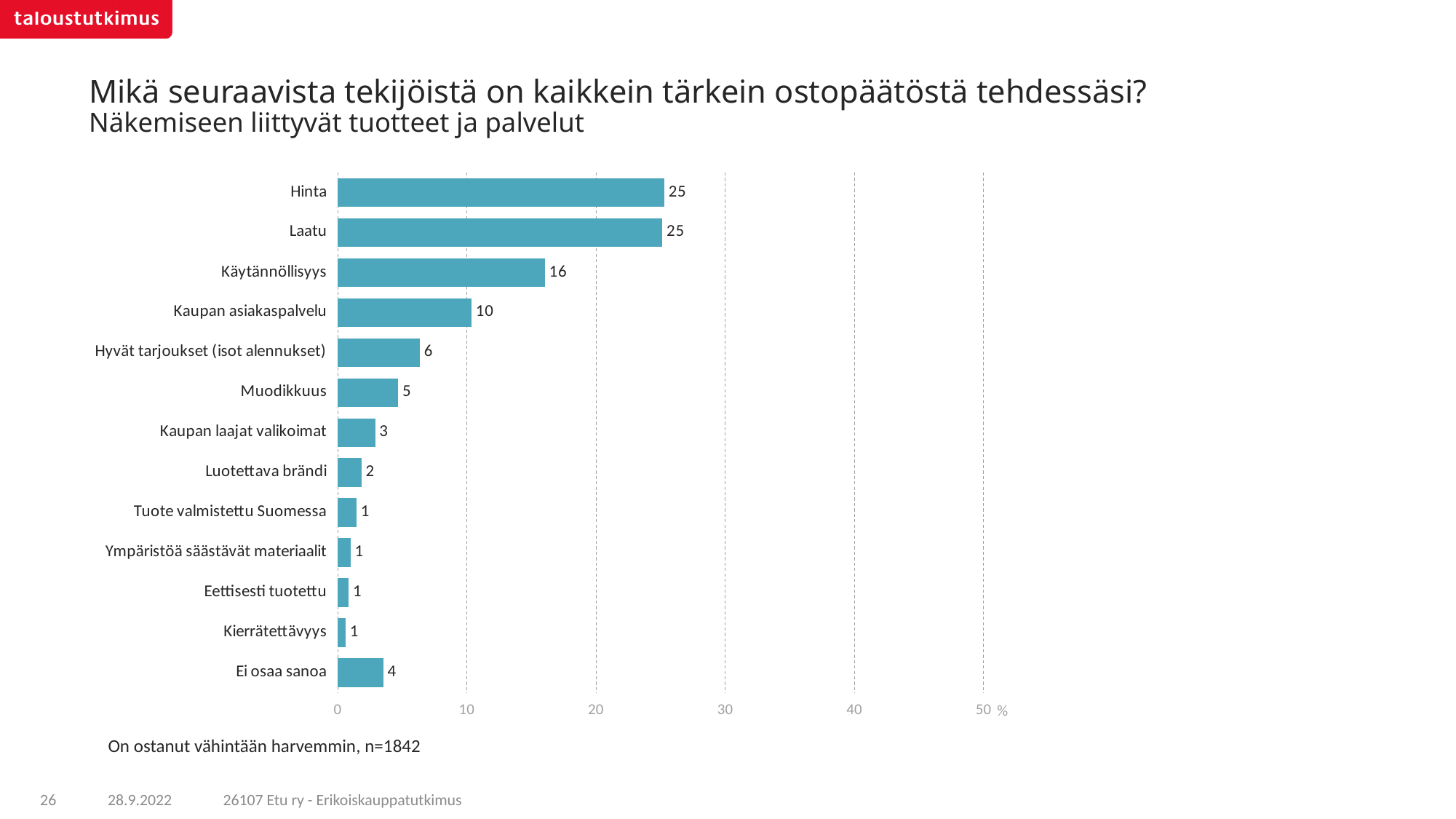
What is the difference between the values for Laatu and Käytännöllisyys? 9 Is the value for Käytännöllisyys greater or less than 10? greater What is the difference between the values for Kaupan asiakaspalvelu and Hyvät tarjoukset (isot alennukset)? 4 What is the value for Käytännöllisyys? 16 How many categories are shown in the chart? 13 What is the value for Muodikkuus? 5 What is the value for Hinta? 25 What is the value for Kaupan asiakaspalvelu? 10 Which has a larger value, Kaupan laajat valikoimat or Luotettava brändi? Kaupan laajat valikoimat What kind of chart is shown on the slide? bar chart What is the value for Ei osaa sanoa? 4 What is the subtitle of the chart below the main question? Näkemiseen liittyvät tuotteet ja palvelut